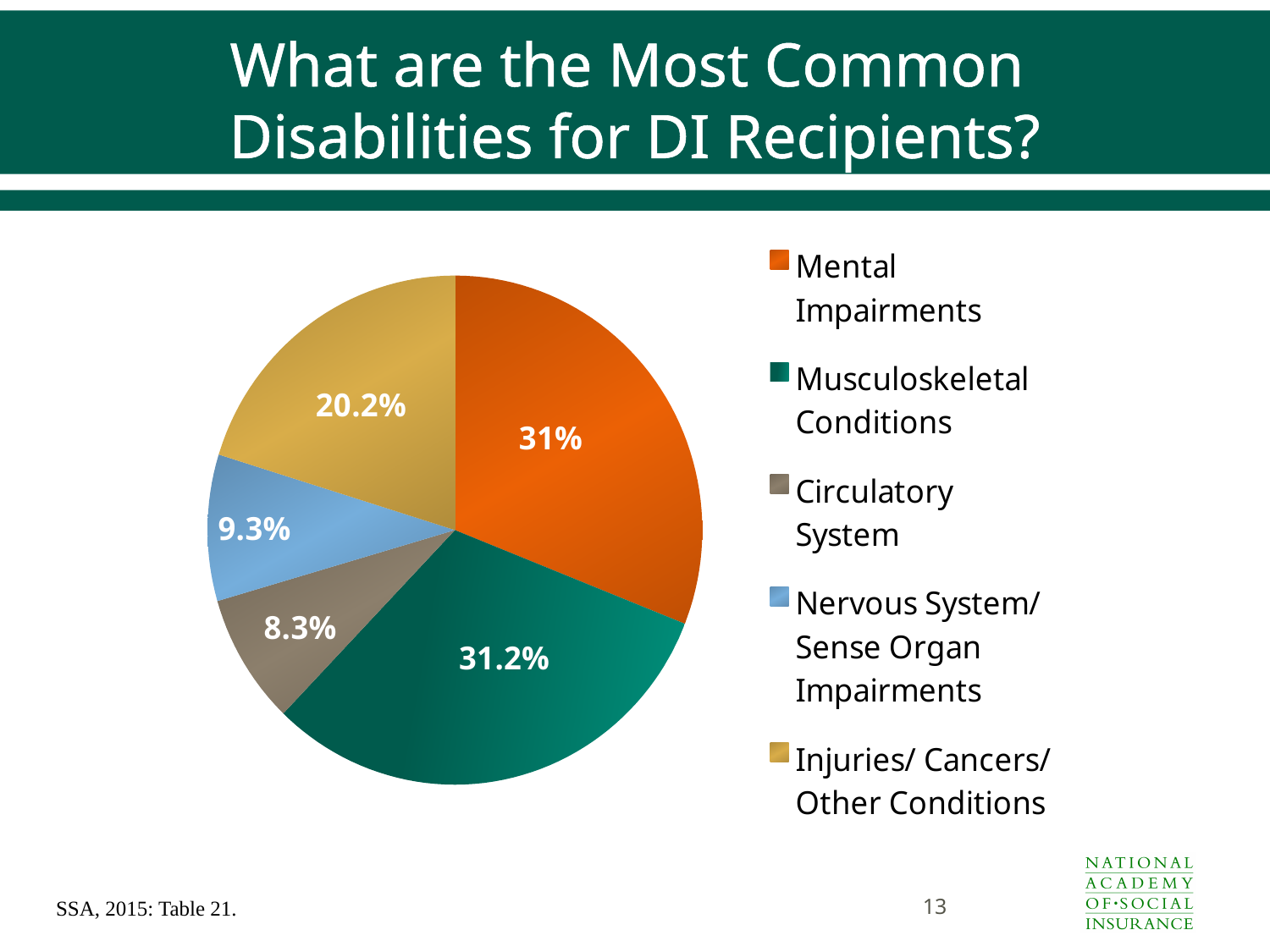
How many categories are shown in the pie chart? 5 What is the value shown for Injuries/ Cancers/ Other Conditions? 20.2% What is the difference in percentage points between Musculoskeletal Conditions and Circulatory System? 22.9 What share of the pie does Mental Impairments represent? 31% What is the difference in percentage points between Injuries/ Cancers/ Other Conditions and Nervous System/ Sense Organ Impairments? 10.9 Which category has the smallest slice of the pie? Circulatory System Which category has the largest slice of the pie? Musculoskeletal Conditions What is the value shown for Nervous System/ Sense Organ Impairments? 9.3% What kind of chart is shown on the slide? Pie chart Which is larger, the slice for Injuries/ Cancers/ Other Conditions or the slice for Nervous System/ Sense Organ Impairments? Injuries/ Cancers/ Other Conditions What is the value shown for Circulatory System? 8.3% What is the value shown for Musculoskeletal Conditions? 31.2%